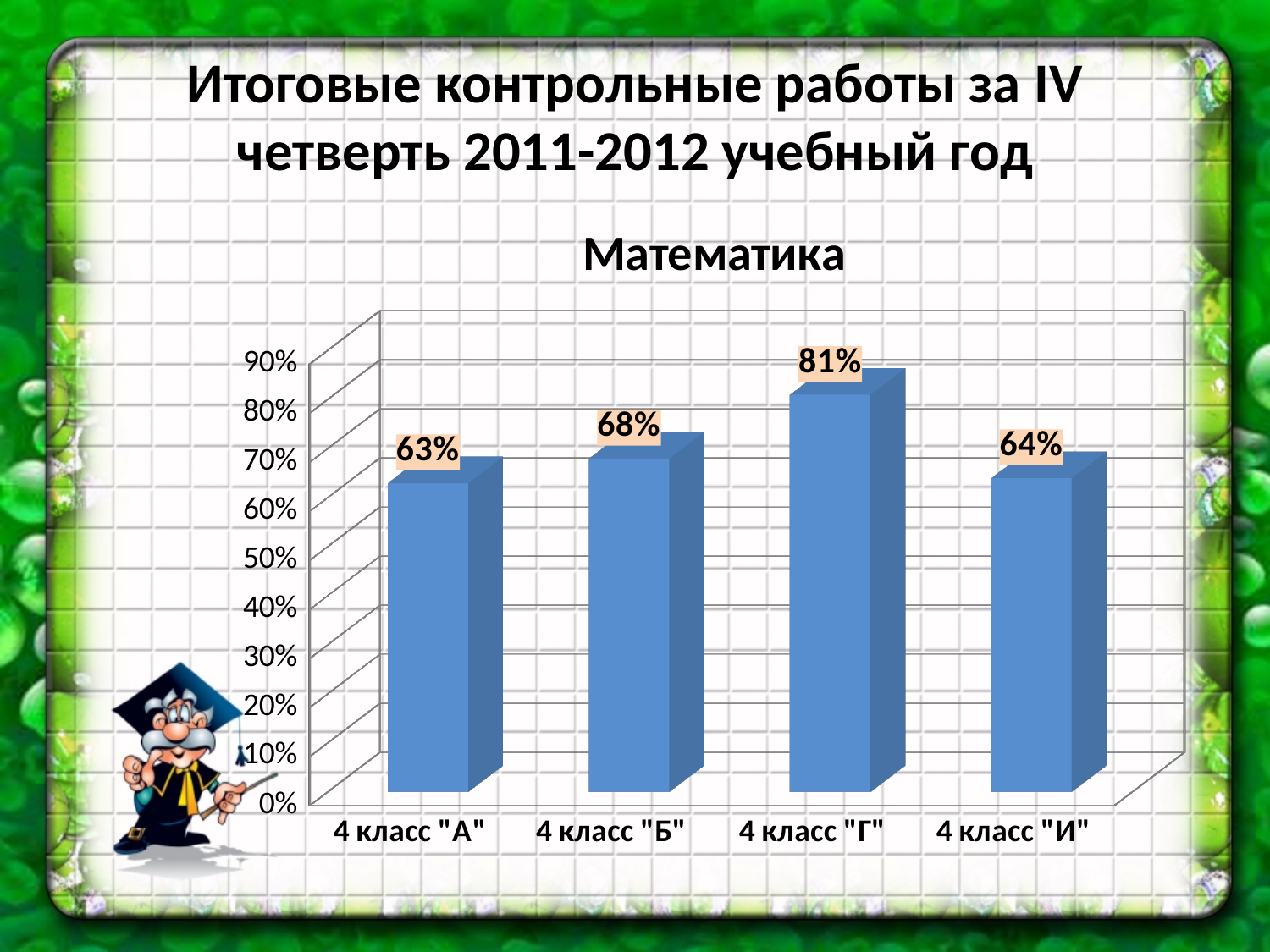
What is the value for 4 класс "А"? 63% Is the value for 4 класс "Г" greater or less than 80%? greater How many classes are shown on the chart? 4 What is the title of the chart? Математика What kind of chart is shown on the slide? bar chart Which class has the highest value? 4 класс "Г" What is the difference between the values for 4 класс "И" and 4 класс "А"? 1% What is the value for 4 класс "Г"? 81% What is the value for 4 класс "И"? 64% What is the difference between the values for 4 класс "Г" and 4 класс "Б"? 13% Which class has the lowest value? 4 класс "А" Which is larger, the value for 4 класс "Б" or 4 класс "И"? 4 класс "Б"